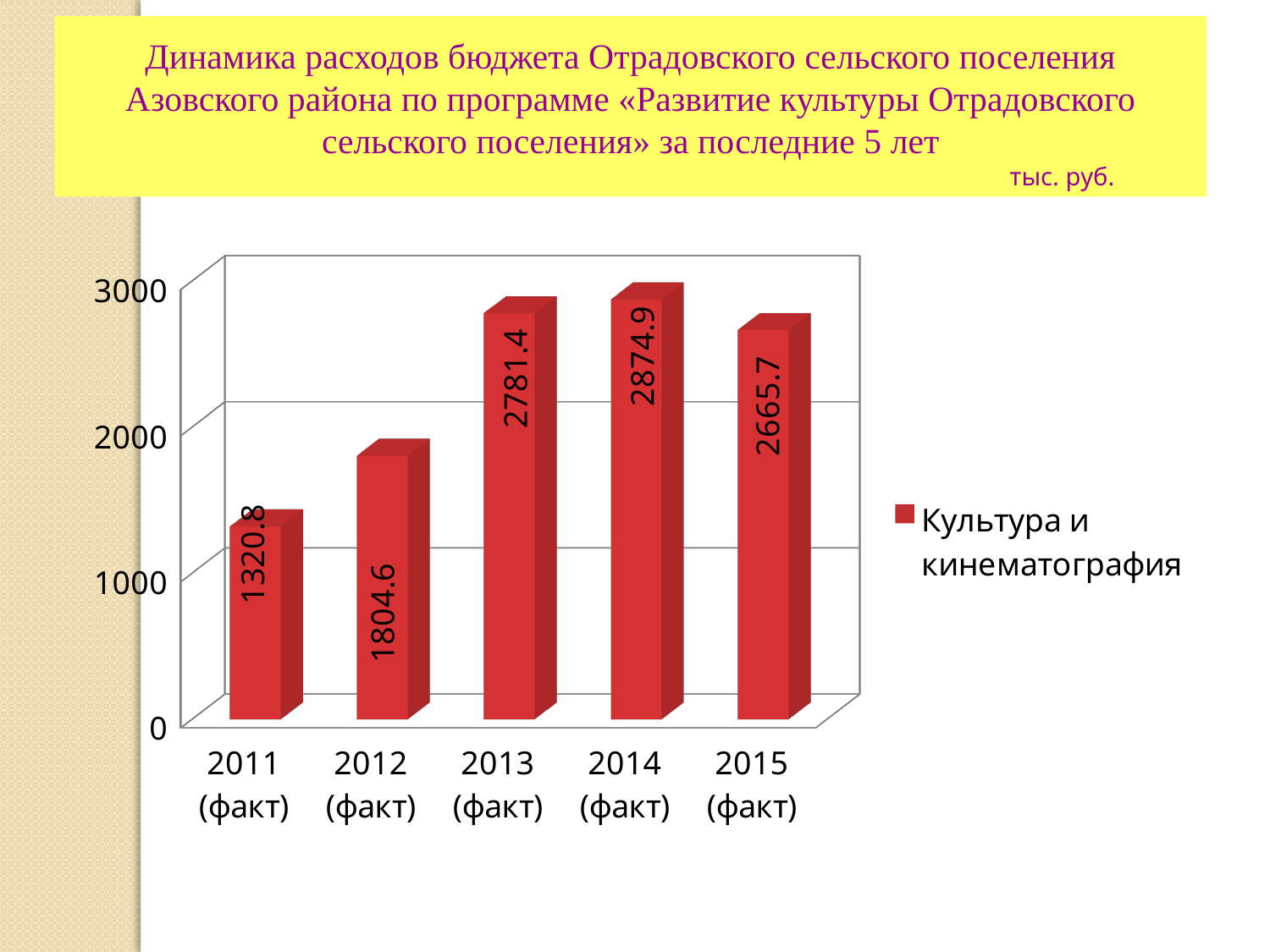
What is the value for 2013 (факт)? 2781.4 Is the value for 2012 (факт) greater or less than 2000? less What is the difference between the values for 2012 (факт) and 2011 (факт)? 483.8 How many years are shown on the x axis? 5 Which year has the lowest value? 2011 (факт) What is the value for 2011 (факт)? 1320.8 What is the difference between the values for 2014 (факт) and 2015 (факт)? 209.2 What kind of chart is shown on the slide? bar chart What series does the legend list? Культура и кинематография What is the value for 2015 (факт)? 2665.7 Which is larger, the value for 2013 (факт) or the value for 2015 (факт)? 2013 (факт) Which year has the highest value? 2014 (факт)